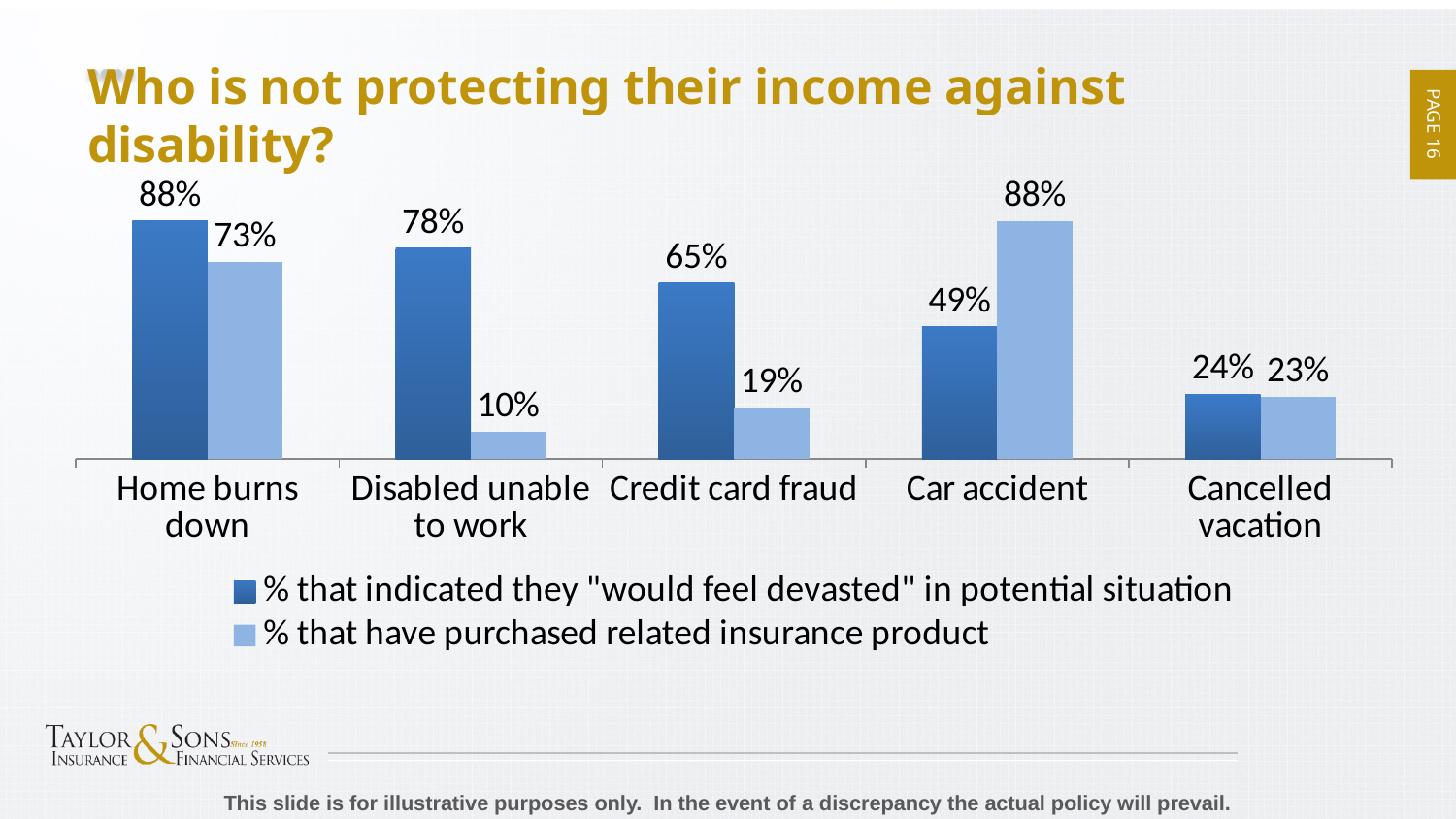
Which category has the lowest value for "% that have purchased related insurance product"? Disabled unable to work How many categories are shown on the x axis? 5 What is the difference between the two values shown for Cancelled vacation? 1% What percentage indicated they "would feel devasted" if their home burns down? 88% How many series does the legend list? 2 Which category has the highest value for "% that indicated they 'would feel devasted' in potential situation"? Home burns down What percentage have purchased a related insurance product for being disabled unable to work? 10% What percentage have purchased a related insurance product for a car accident? 88% What is the difference between the "would feel devasted" percentage and the purchased insurance percentage for Disabled unable to work? 68% What kind of chart is shown on the slide? Bar chart For Car accident, which is larger: the "would feel devasted" percentage or the purchased insurance percentage? % that have purchased related insurance product What percentage indicated they "would feel devasted" by credit card fraud? 65%